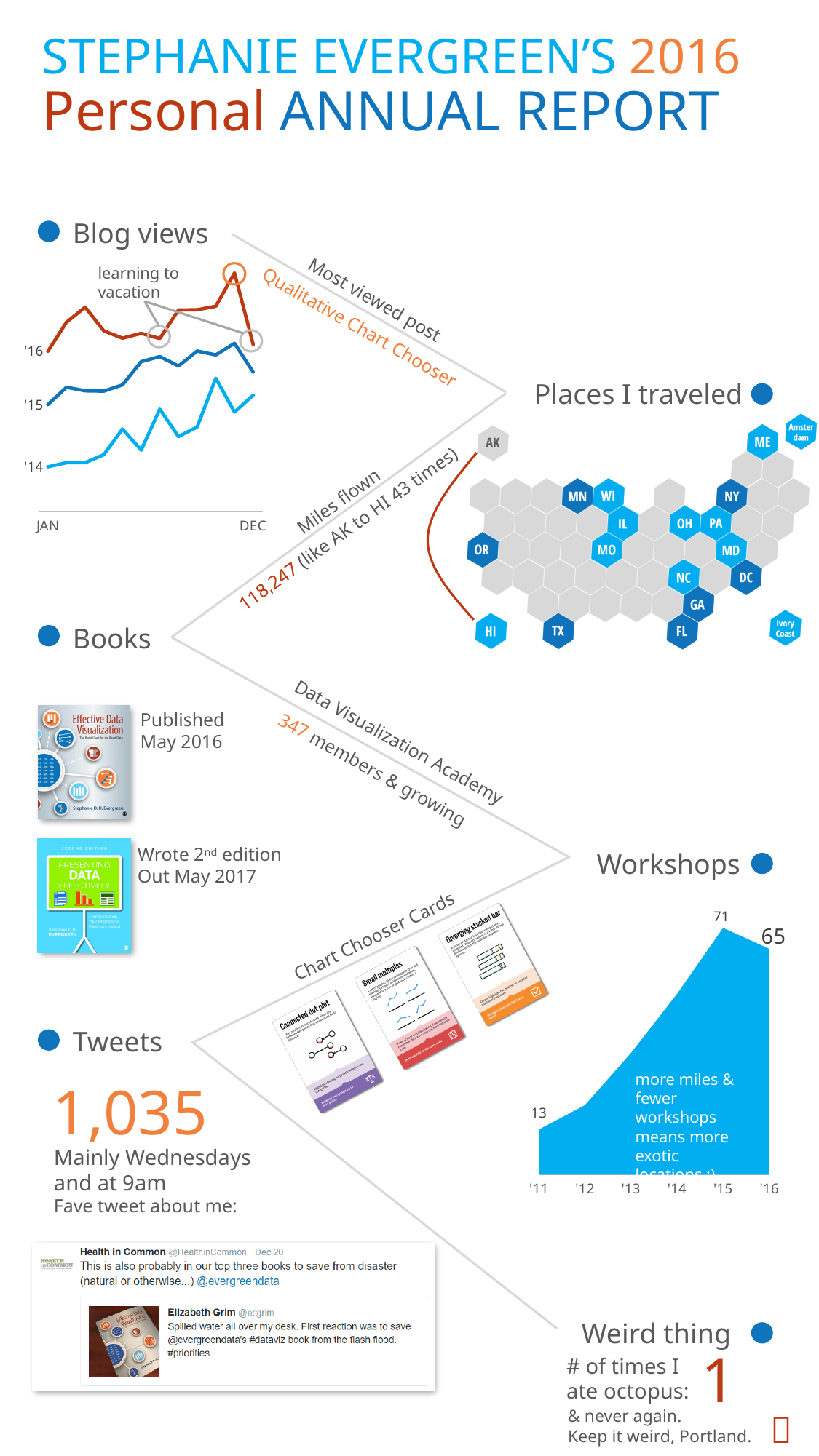
In the Workshops chart, what is the difference between the values for '15 and '16? 6 How many years are shown on the x axis of the Workshops chart? 6 What kind of chart is the Blog views chart? line chart In the Workshops chart, do the values rise or fall from '11 to '15? rise In the Workshops chart, which year has the highest value? '15 In the Blog views chart, which year's line is the highest overall? '16 In the Workshops chart, what is the value for '15? 71 In the Workshops chart, what is the value for '16? 65 In the Workshops chart, which year has the lowest value? '11 How many series (years) are plotted in the Blog views chart? 3 In the Workshops chart, what is the value for '11? 13 In the Workshops chart, which is larger, the value for '15 or the value for '16? '15